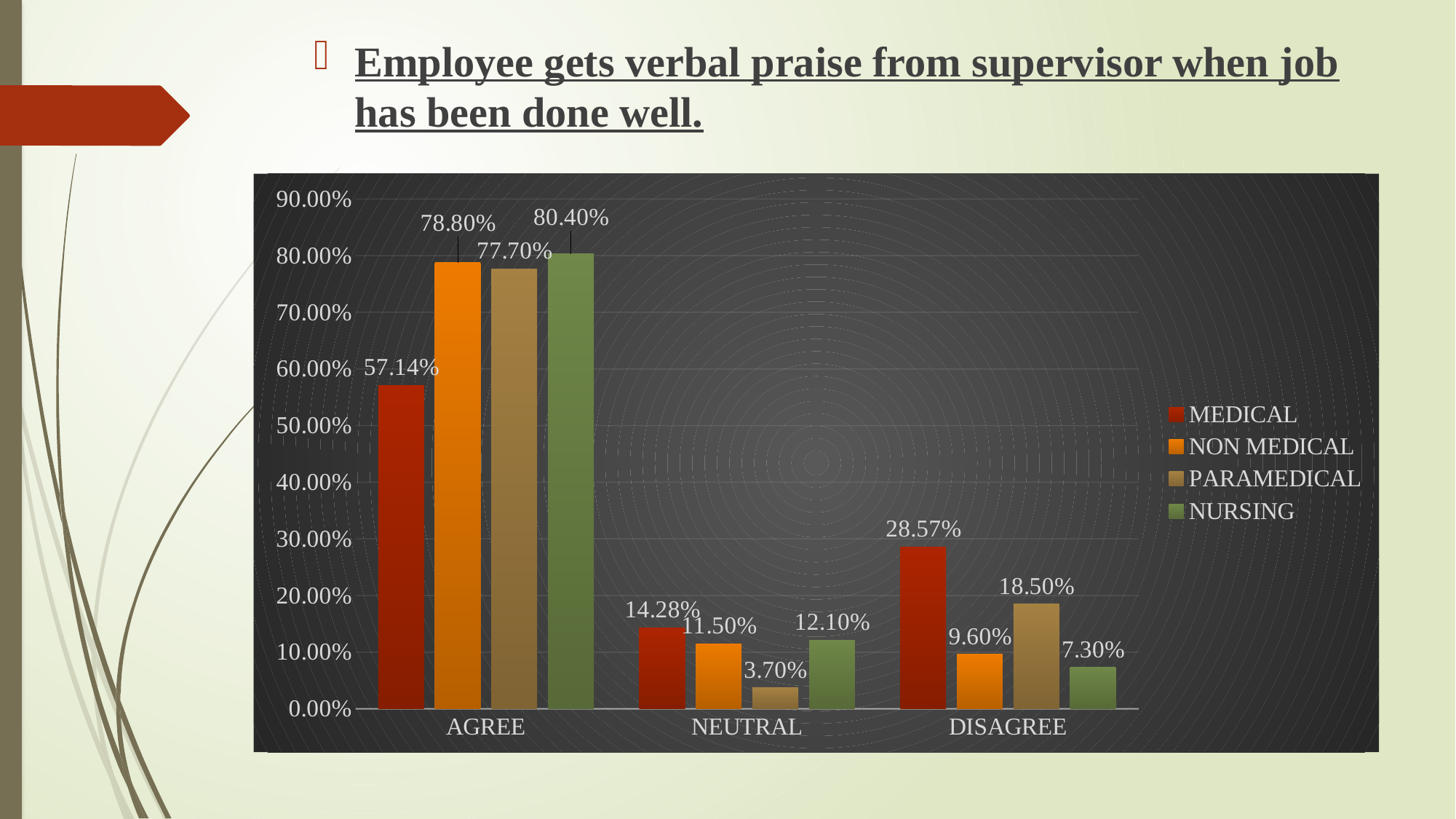
In the NEUTRAL category, which is larger: the MEDICAL value or the NURSING value? MEDICAL What is the value for NON MEDICAL in the DISAGREE category? 9.60% What is the value for PARAMEDICAL in the NEUTRAL category? 3.70% How many categories are shown on the x axis? 3 What is the difference between the MEDICAL and NON MEDICAL values in the DISAGREE category? 18.97% What is the value for MEDICAL in the AGREE category? 57.14% What kind of chart is shown on the slide? Bar chart Which series has the highest value in the AGREE category? NURSING How many series does the legend list? 4 Which series has the lowest value in the DISAGREE category? NURSING What is the value for NURSING in the AGREE category? 80.40% Which series is shown in green in the legend? NURSING